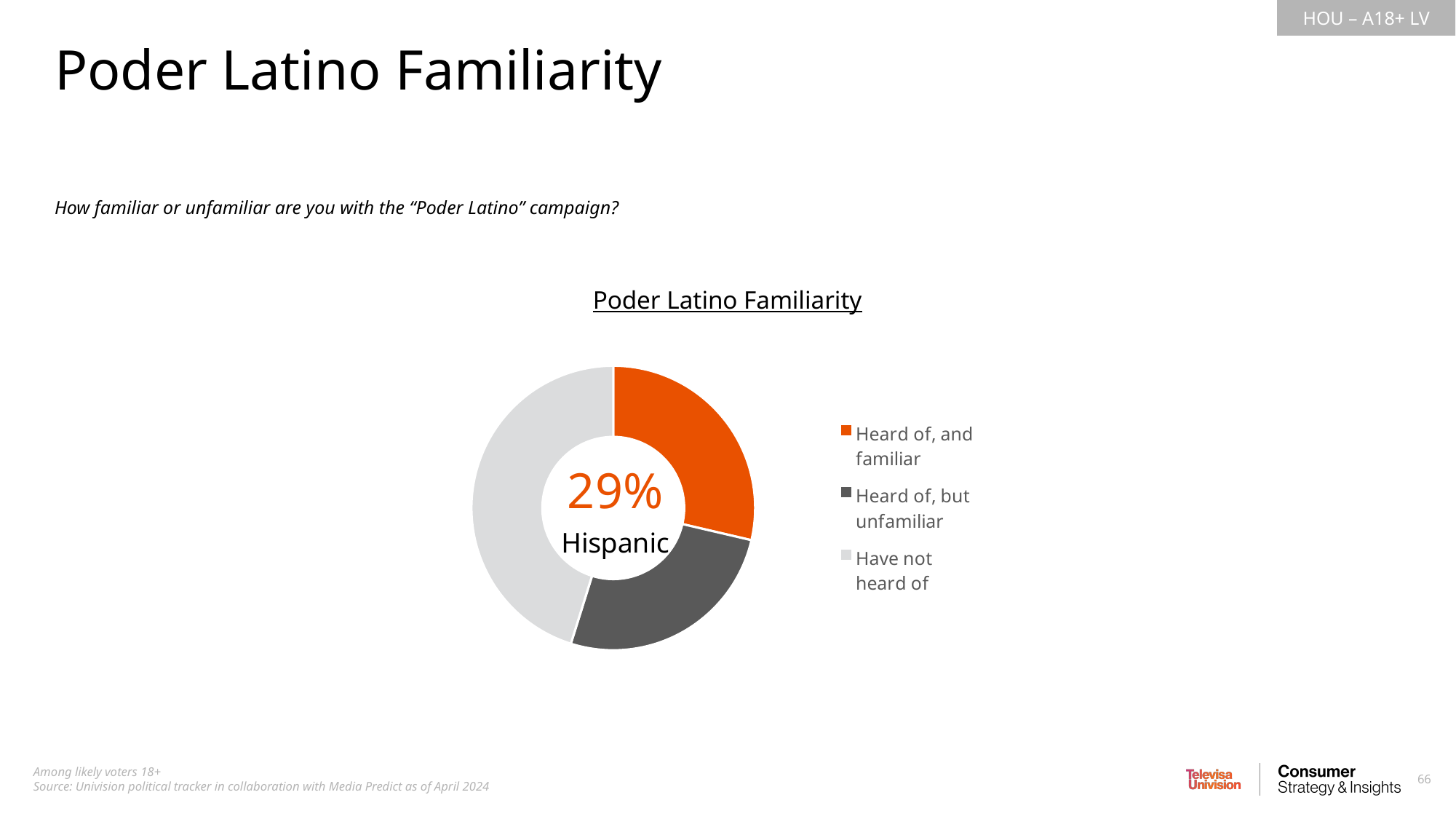
What colour represents "Heard of, and familiar" in the chart? orange How many slices does the donut chart have? 3 Which group label appears in the center of the donut chart below the percentage? Hispanic What percentage is printed in the center of the Poder Latino Familiarity donut chart? 29% What is the title of the chart? Poder Latino Familiarity Which slice is larger: "Have not heard of" or "Heard of, and familiar"? Have not heard of How many categories does the legend of the Poder Latino Familiarity chart list? 3 What kind of chart is shown on the slide? donut chart What share of Hispanic likely voters have heard of, and are familiar with, the Poder Latino campaign? 29% Which category takes up the largest slice of the donut chart? Have not heard of